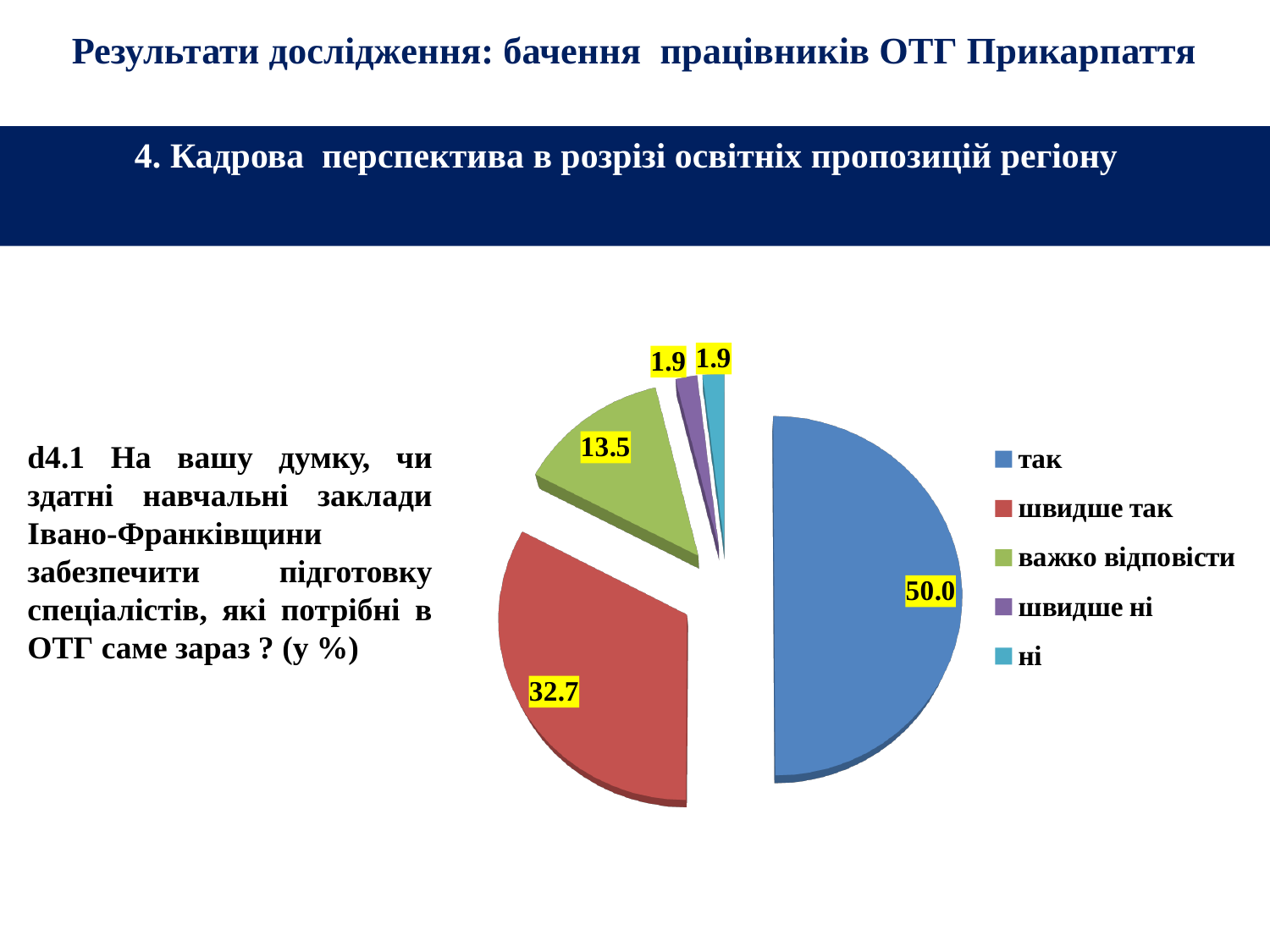
What is the value for "швидше ні"? 1.9 What is the value for "так"? 50.0 What is the value for "ні"? 1.9 Which is larger, the value for "важко відповісти" or the value for "швидше ні"? важко відповісти What colour is the slice for "важко відповісти"? green How many categories does the legend list? 5 What is the difference between the values for "швидше так" and "важко відповісти"? 19.2 What is the value for "важко відповісти"? 13.5 What is the difference between the values for "так" and "швидше так"? 17.3 What kind of chart is shown on the slide? pie chart Which category has the largest slice of the pie? так What is the value for "швидше так"? 32.7